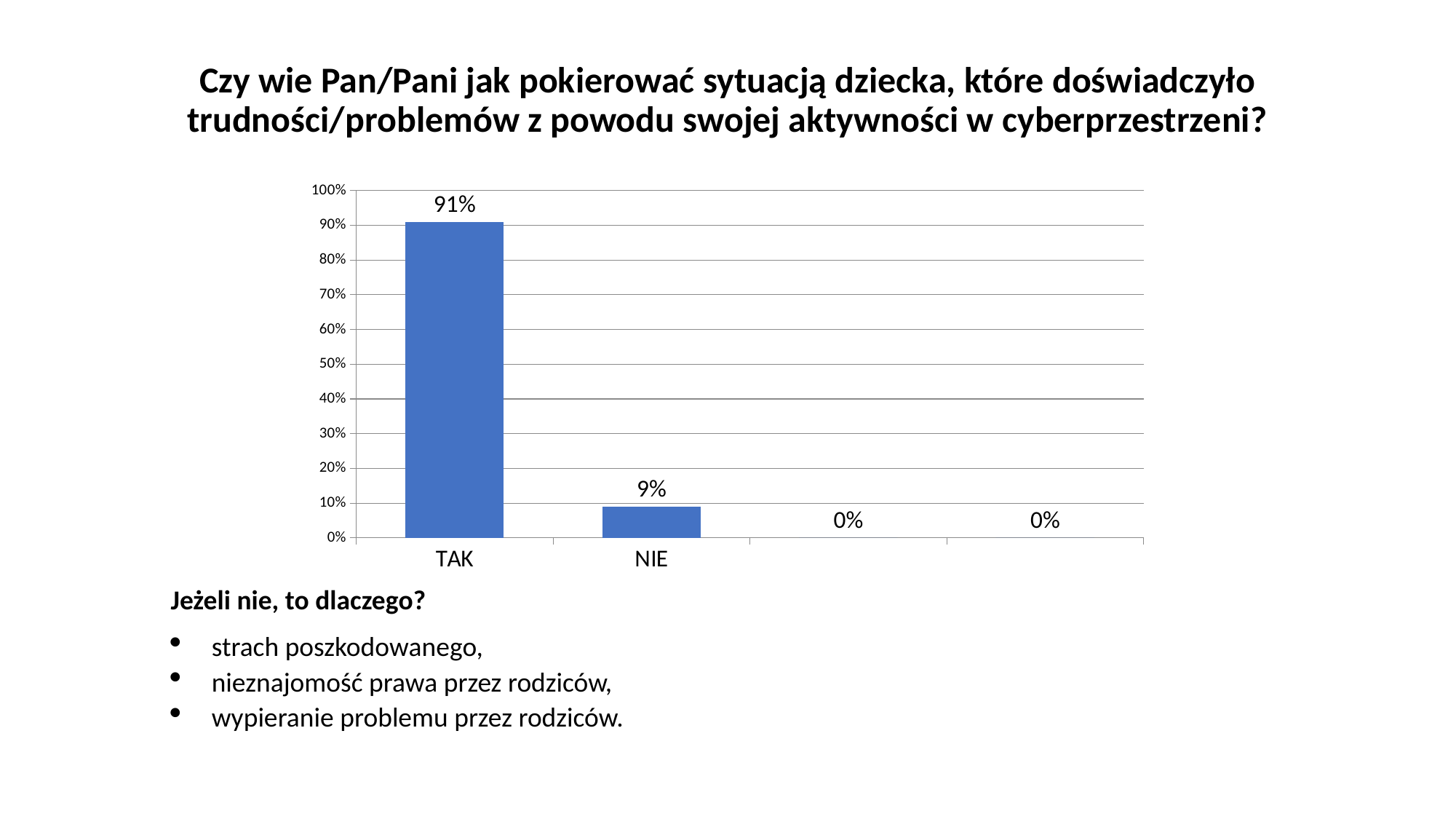
How many data labels on the chart show 0%? 2 What is the difference between the values for TAK and NIE? 82% What is the highest value shown on the y axis? 100% What is the value for TAK? 91% What kind of chart is shown on the slide? bar chart Is the value for TAK greater or less than 50%? greater What is the value for NIE? 9% What colour are the bars in the chart? blue How many categories have a labelled name on the x axis? 2 Which is larger, the value for TAK or the value for NIE? TAK Is the value for NIE greater or less than 20%? less Which category has the highest value? TAK